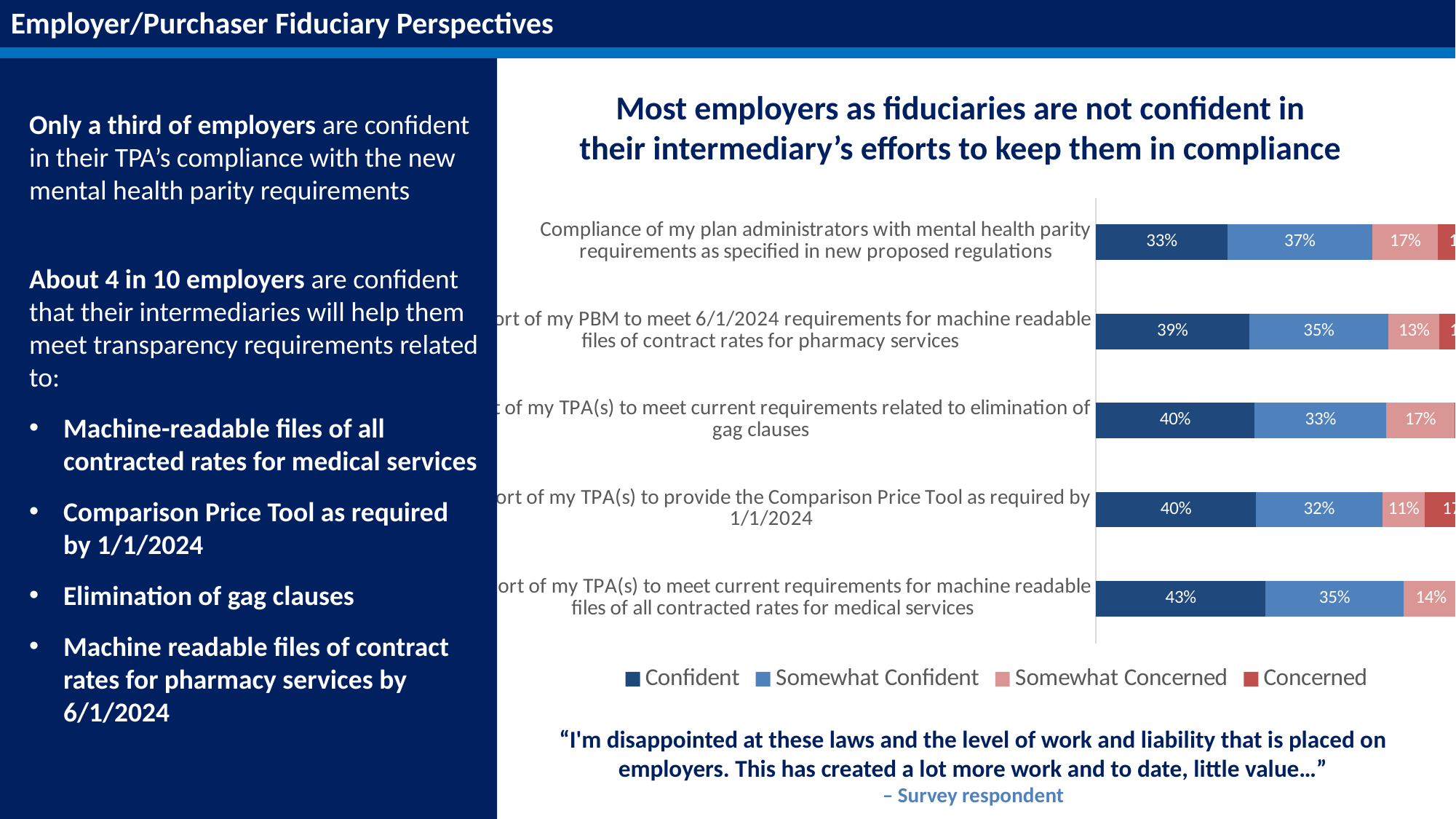
What percentage of employers are Somewhat Confident in their PBM meeting the 6/1/2024 machine readable file requirements for pharmacy services? 35% What kind of chart is shown on the slide? Stacked bar chart Which category has the lowest Confident percentage? Compliance of my plan administrators with mental health parity requirements as specified in new proposed regulations How many categories (bars) does the chart show? 5 What percentage of employers are Confident in the compliance of their plan administrators with mental health parity requirements? 33% What percentage of employers are Somewhat Concerned about their TPA(s) meeting current requirements related to elimination of gag clauses? 17% What is the difference between the Confident percentage for machine readable files for medical services (43%) and for mental health parity compliance (33%)? 10% What is the title of the chart? Most employers as fiduciaries are not confident in their intermediary's efforts to keep them in compliance Which category has the highest Confident percentage? Support of my TPA(s) to meet current requirements for machine readable files of all contracted rates for medical services Which is larger: the Somewhat Concerned percentage for the Comparison Price Tool or for elimination of gag clauses? Elimination of gag clauses How many series does the chart legend list? 4 What percentage of employers are Confident in their TPA(s) meeting current requirements for machine readable files of all contracted rates for medical services? 43%